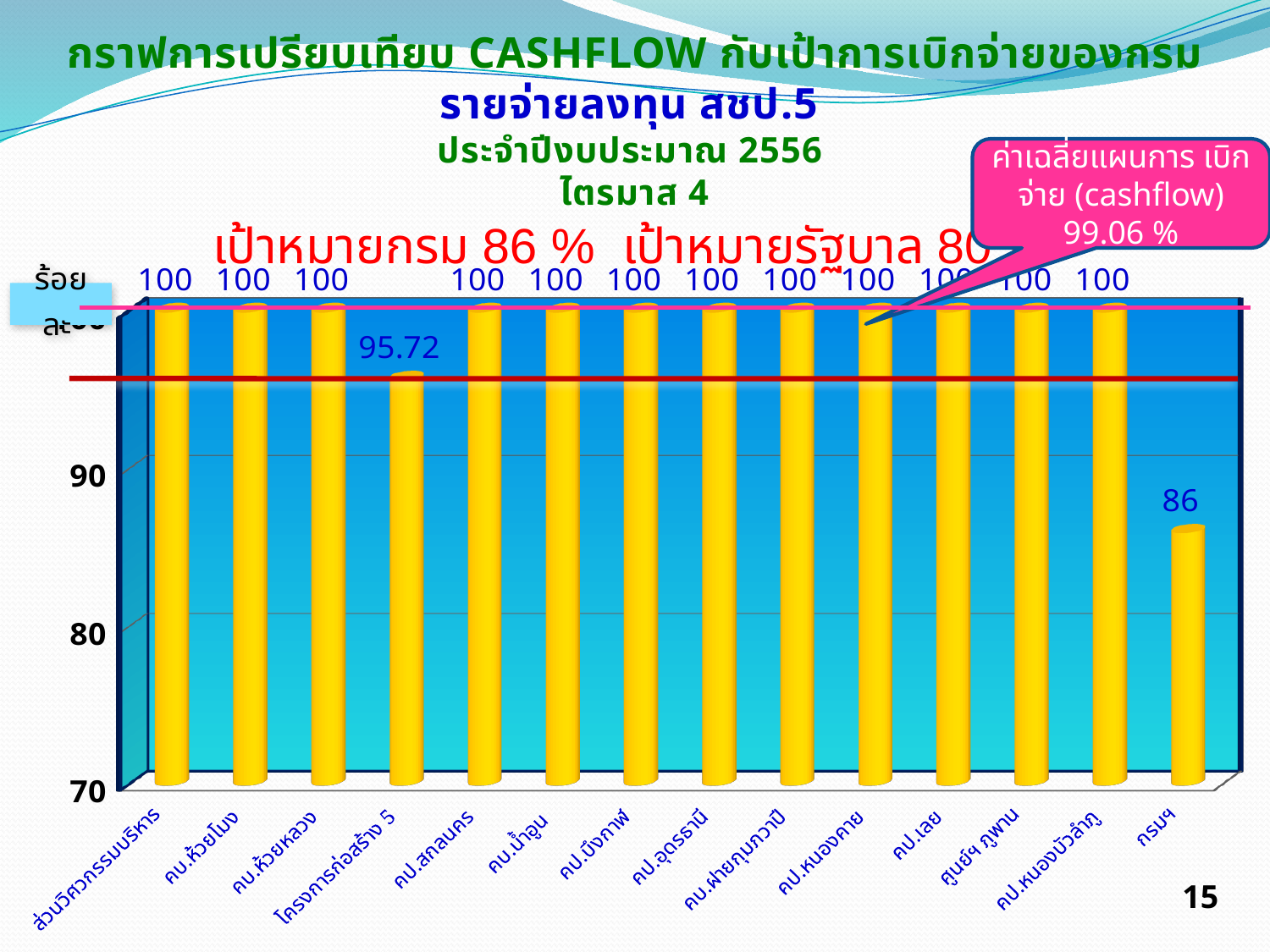
What is the difference between the value for โครงการก่อสร้าง 5 and the value for กรมฯ? 9.72 How many categories are shown on the x axis? 14 What is the difference between the value for คบ.ห้วยโมง and the value for โครงการก่อสร้าง 5? 4.28 According to the callout, what is the average cashflow disbursement plan value? 99.06 % Which is larger, the value for โครงการก่อสร้าง 5 or the value for กรมฯ? โครงการก่อสร้าง 5 What is the value for โครงการก่อสร้าง 5? 95.72 Which category has the lowest value? กรมฯ What is the department target (เป้าหมายกรม) stated above the chart? 86 % What is the value for กรมฯ? 86 Is the value for กรมฯ greater or less than 90? less What kind of chart is shown on the slide? bar chart